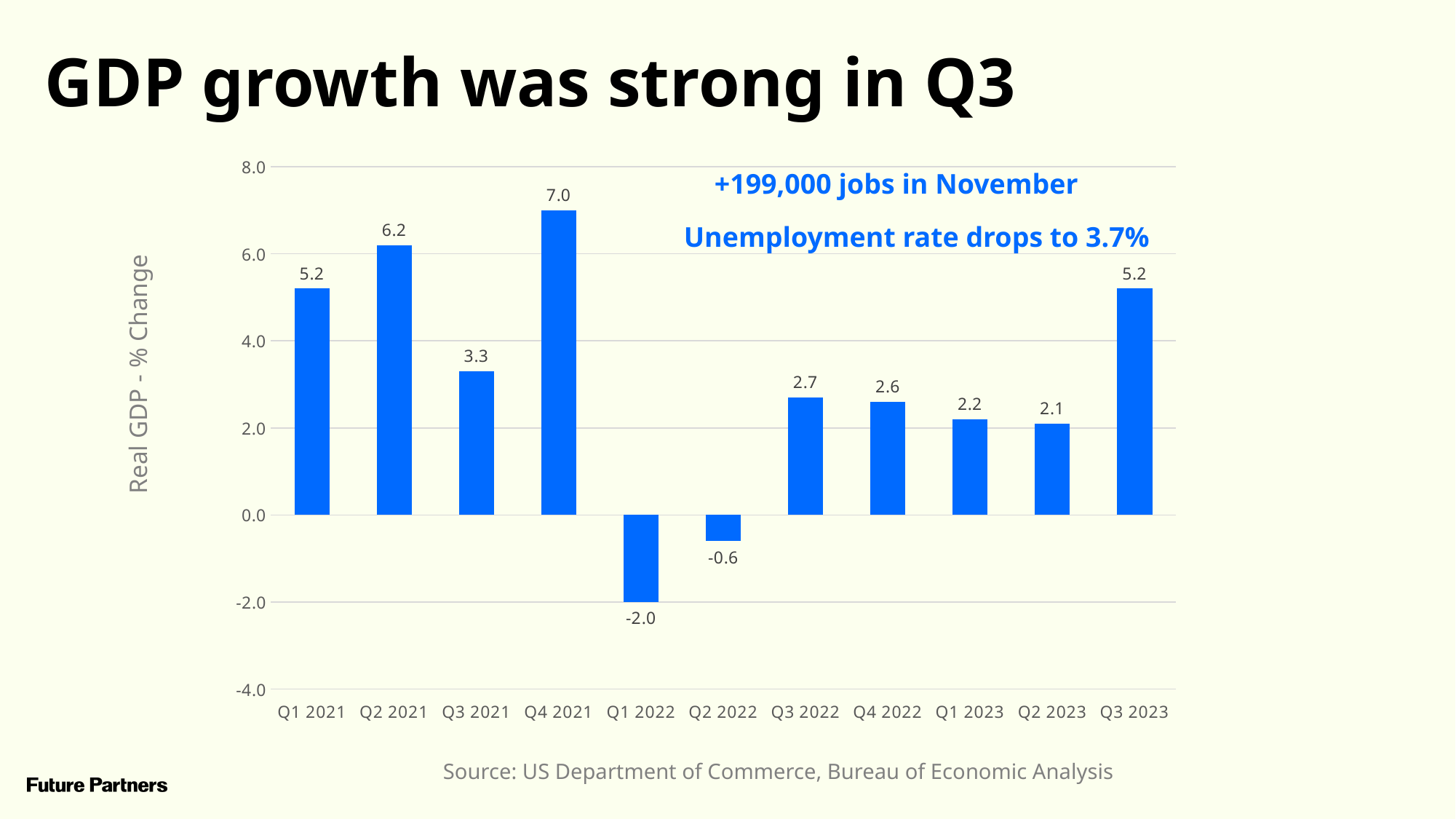
Do the Real GDP % change values rise or fall from Q3 2022 to Q2 2023? Fall What kind of chart is shown on the slide? Bar chart What is the label of the vertical axis? Real GDP - % Change How many quarters have a negative Real GDP % change? 2 What is the Real GDP % change for Q3 2023? 5.2 Which quarter has the highest Real GDP % change? Q4 2021 How many quarters are shown on the x axis? 11 Which is larger, the Real GDP % change for Q2 2021 or Q3 2021? Q2 2021 What is the difference between the Real GDP % change in Q3 2023 and Q2 2023? 3.1 What is the Real GDP % change for Q4 2021? 7.0 What is the Real GDP % change for Q1 2022? -2.0 Which quarter has the lowest Real GDP % change? Q1 2022